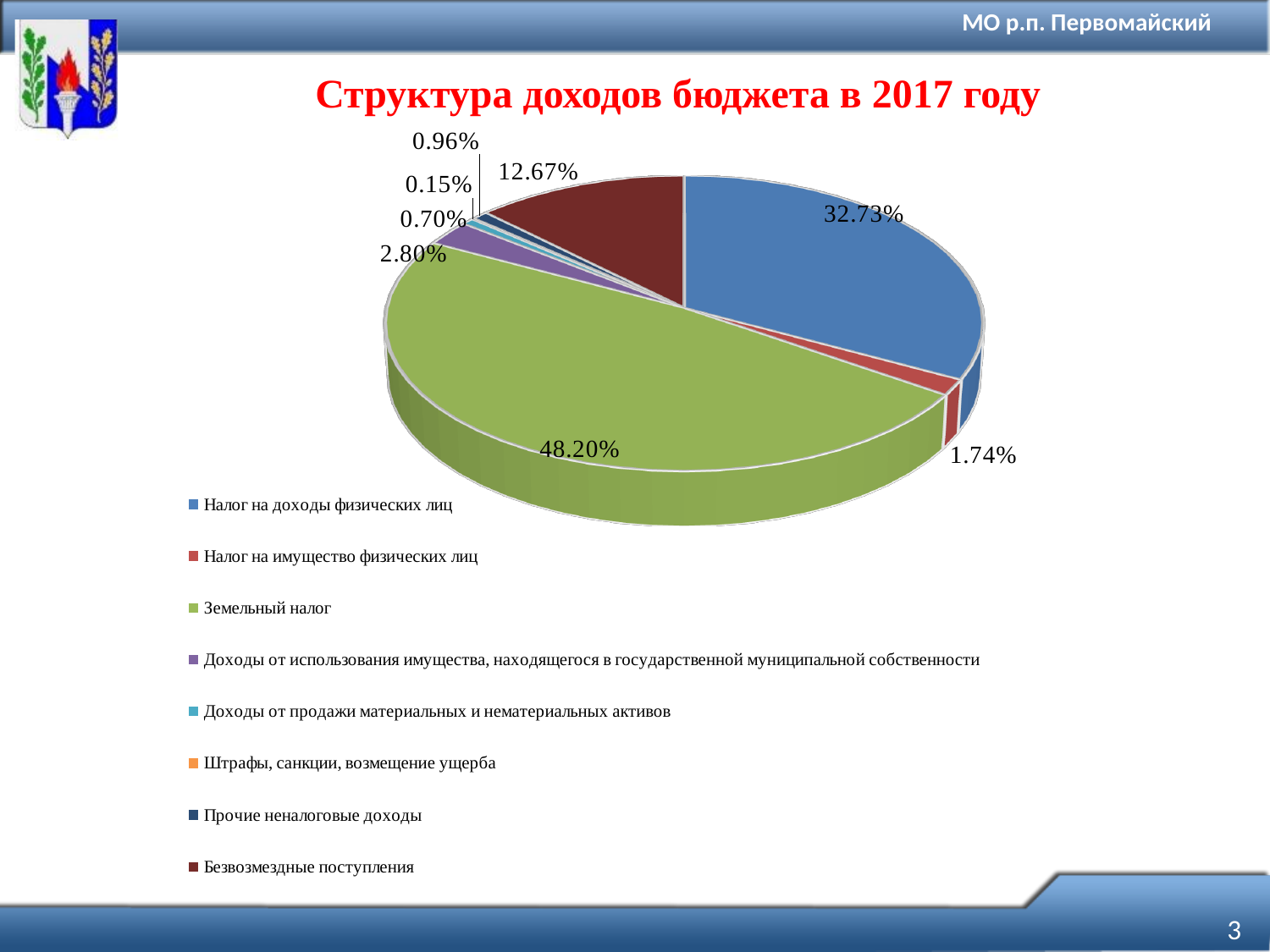
How many categories does the legend list? 8 What is the difference between the share for Земельный налог and the share for Налог на доходы физических лиц? 15.47% What share of the pie is Земельный налог? 48.20% What share of the pie is Доходы от использования имущества, находящегося в государственной муниципальной собственности? 2.80% Which category has the smallest share of the pie? Штрафы, санкции, возмещение ущерба What is the title of the chart? Структура доходов бюджета в 2017 году Which is larger: the share for Налог на доходы физических лиц or the share for Безвозмездные поступления? Налог на доходы физических лиц What share of the pie is Безвозмездные поступления? 12.67% What type of chart is shown on the slide? pie chart Which category has the largest share of the pie? Земельный налог